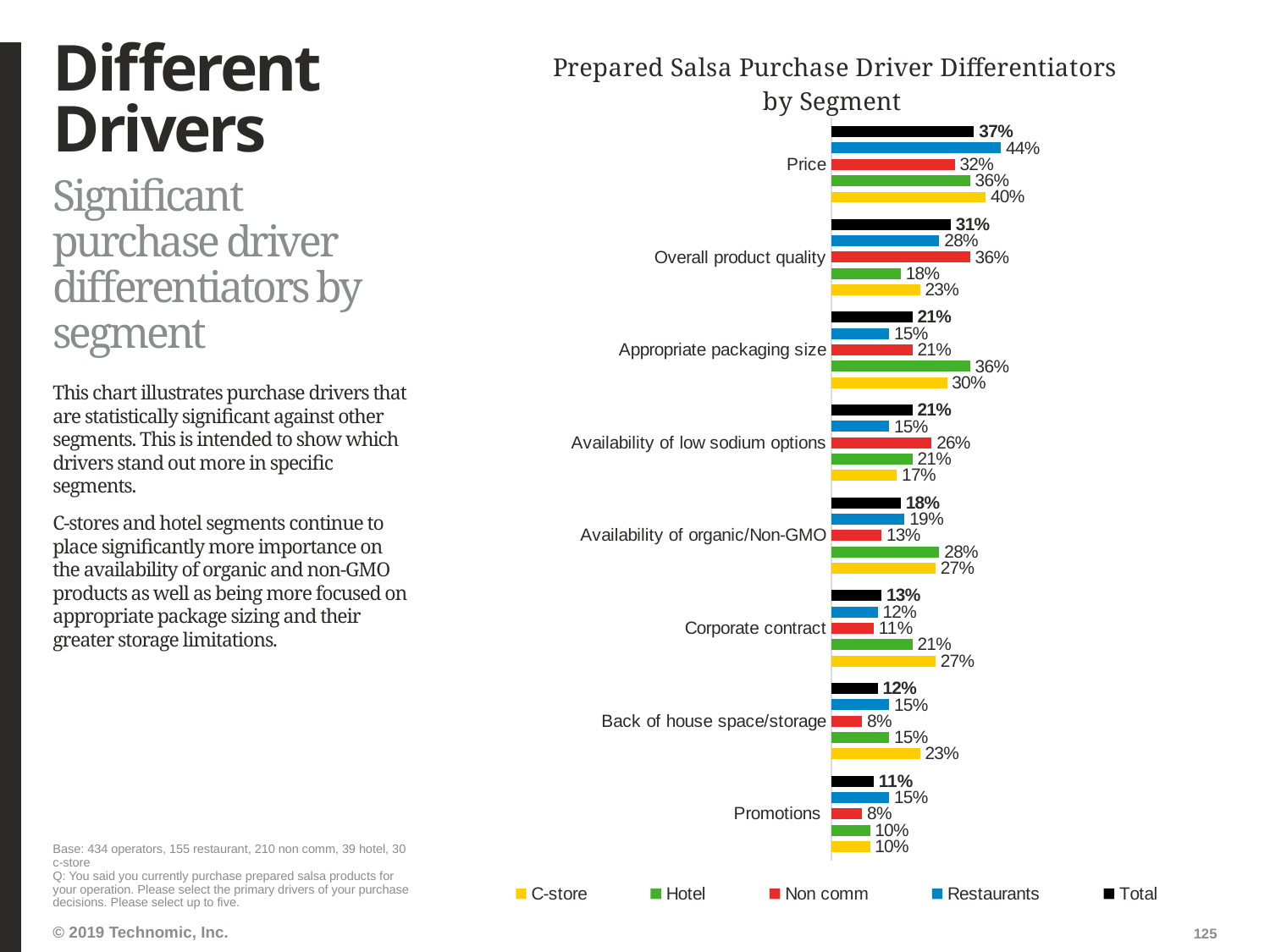
How many series does the legend list? 5 What kind of chart is shown on the slide? Bar chart Which is larger for Back of house space/storage, the C-store value or the Non comm value? C-store What is the title of the chart? Prepared Salsa Purchase Driver Differentiators by Segment Which category has the highest Total value? Price What is the C-store value for Corporate contract? 27% What is the Restaurants value for Price? 44% What is the Hotel value for Appropriate packaging size? 36% What is the difference between the Hotel and Non comm values for Availability of organic/Non-GMO? 15% What is the Non comm value for Overall product quality? 36% Which category has the lowest Total value? Promotions How many categories are shown on the chart? 8